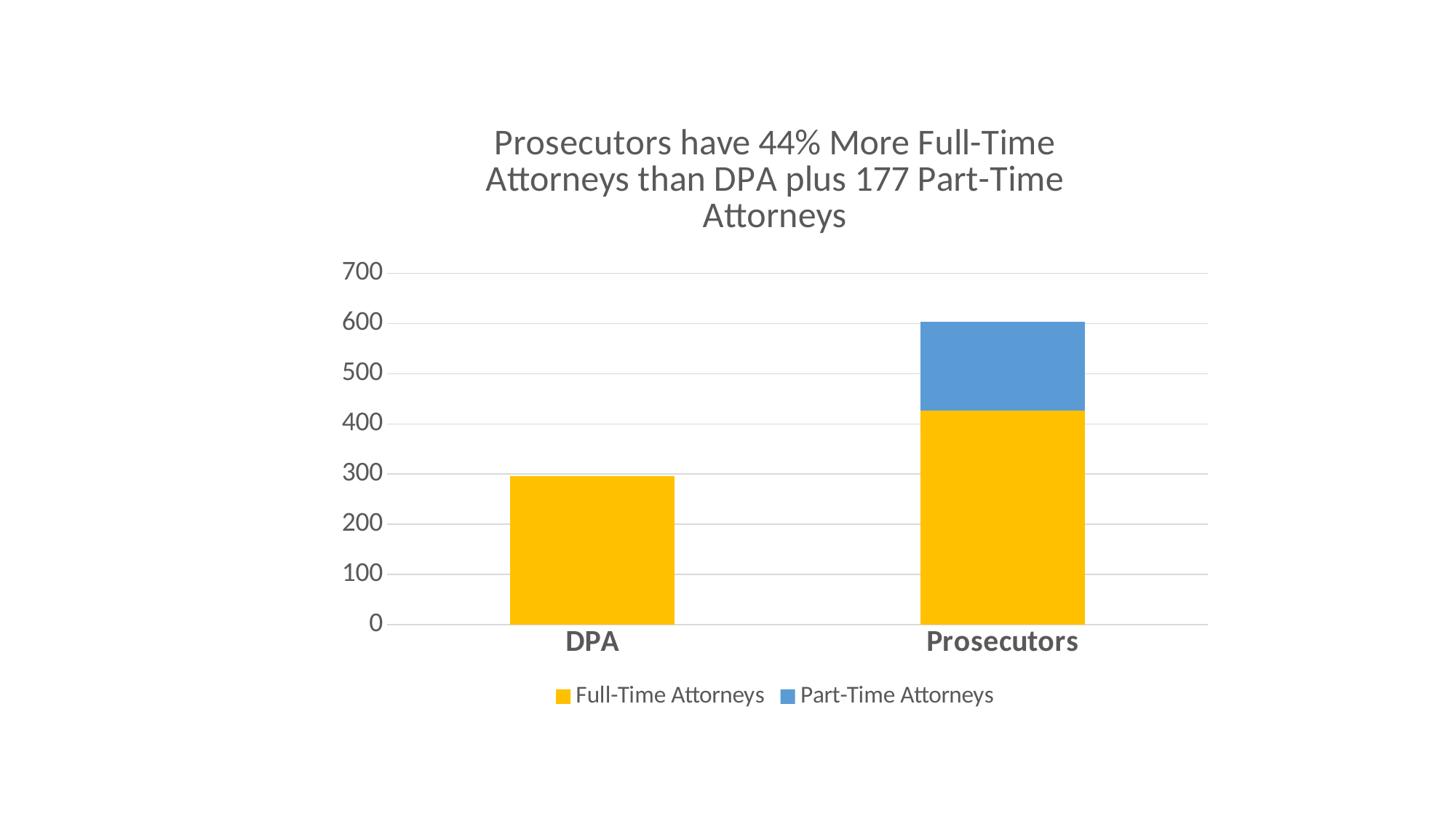
Is the Full-Time Attorneys value for Prosecutors greater or less than 400? greater Is the Full-Time Attorneys value for DPA greater or less than 200? greater What kind of chart is shown on the slide? Stacked bar chart What colour represents Part-Time Attorneys in the legend? Blue Which category has the larger Full-Time Attorneys value, DPA or Prosecutors? Prosecutors Which category shows a Part-Time Attorneys segment? Prosecutors Which category has the shorter bar overall? DPA How many series does the legend list? 2 Is the Full-Time Attorneys value for DPA greater or less than 400? less How many categories are shown on the x axis? 2 Which category has the taller bar overall, DPA or Prosecutors? Prosecutors